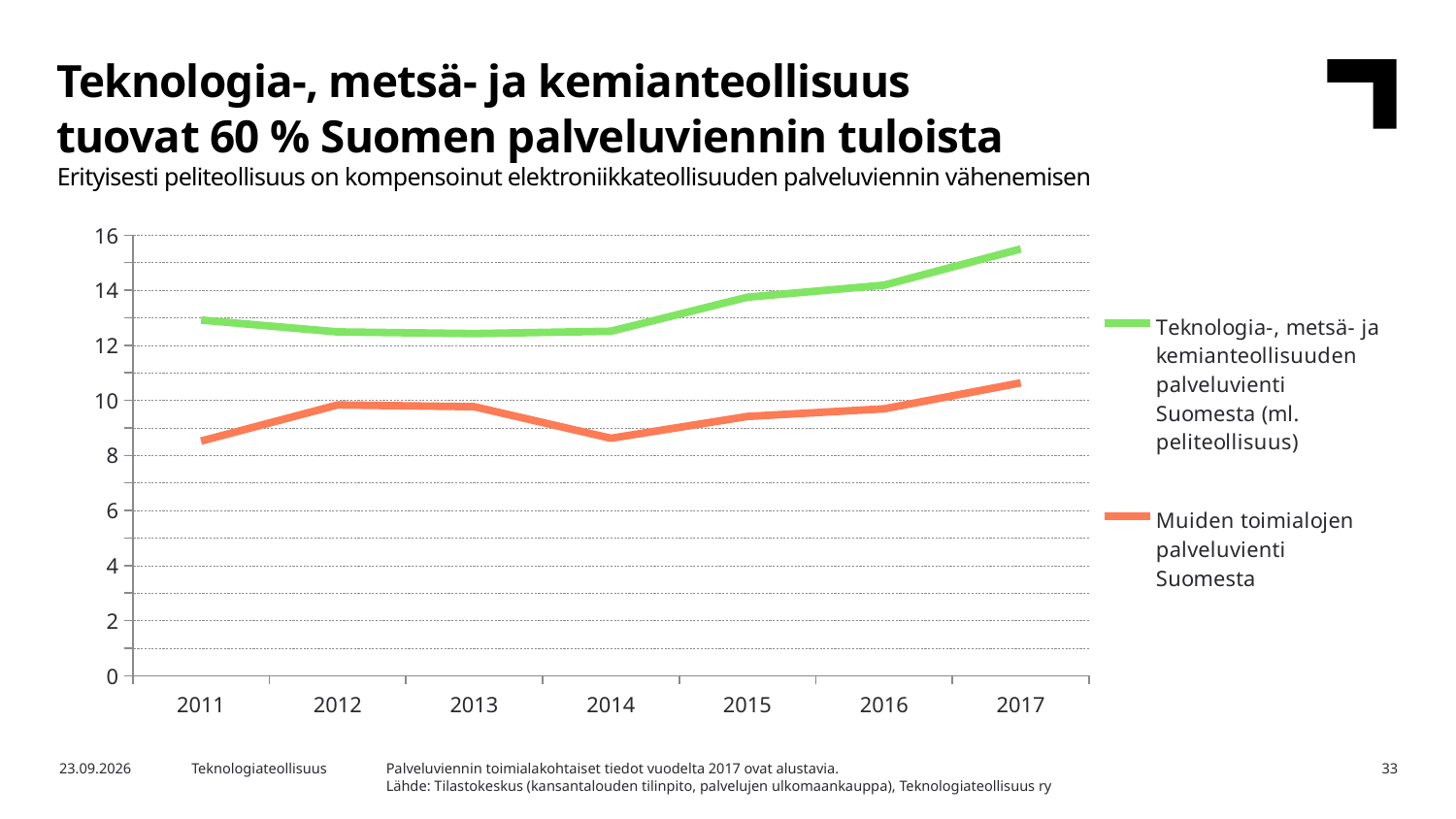
Is the value for the orange series in 2017 greater or less than 10? greater Which year has the highest value for the green series (Teknologia-, metsä- ja kemianteollisuuden palveluvienti Suomesta)? 2017 Which year has the highest value for the orange series (Muiden toimialojen palveluvienti Suomesta)? 2017 How many series does the legend list? 2 Is the value for the green series in 2013 greater or less than 12? greater What kind of chart is shown on the slide? line chart Is the value for the green series in 2017 greater or less than 14? greater How many years are shown on the x axis? 7 Which series is drawn in orange according to the legend? Muiden toimialojen palveluvienti Suomesta Does the green series rise or fall between 2014 and 2017? rise In 2015, which series has the larger value: the green series or the orange series? the green series